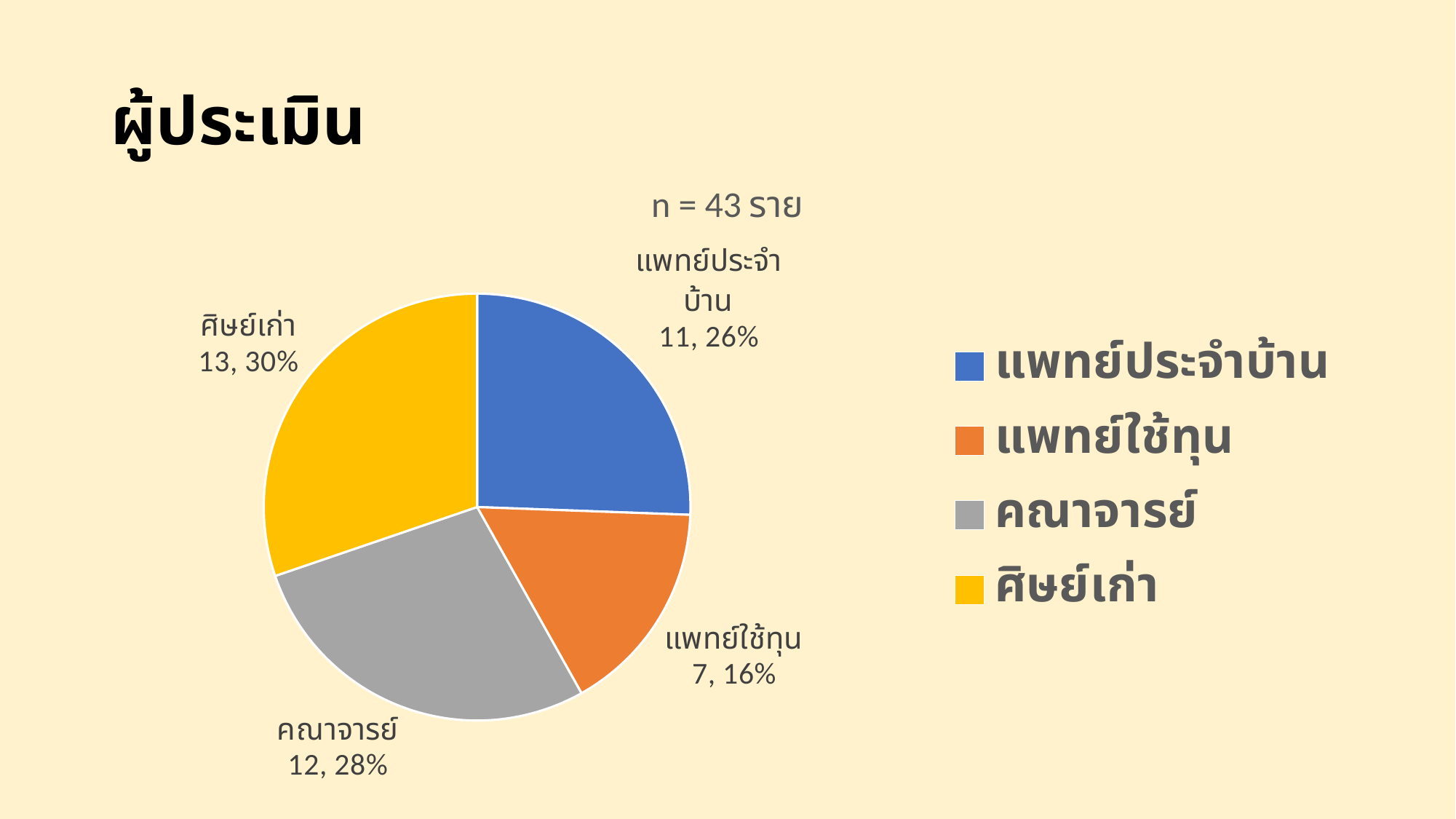
What percentage share does คณาจารย์ have? 28% What is the count for แพทย์ประจำบ้าน? 11 How many slices does the pie chart have? 4 Which is larger, the count for แพทย์ประจำบ้าน or คณาจารย์? คณาจารย์ Which category has the smallest slice? แพทย์ใช้ทุน How many entries does the legend list? 4 What type of chart is shown on the slide? Pie chart What percentage share does ศิษย์เก่า have? 30% Which category has the largest slice? ศิษย์เก่า What is the difference in count between ศิษย์เก่า and แพทย์ใช้ทุน? 6 What total sample size (n) is stated above the chart? n = 43 ราย What is the count for แพทย์ใช้ทุน? 7